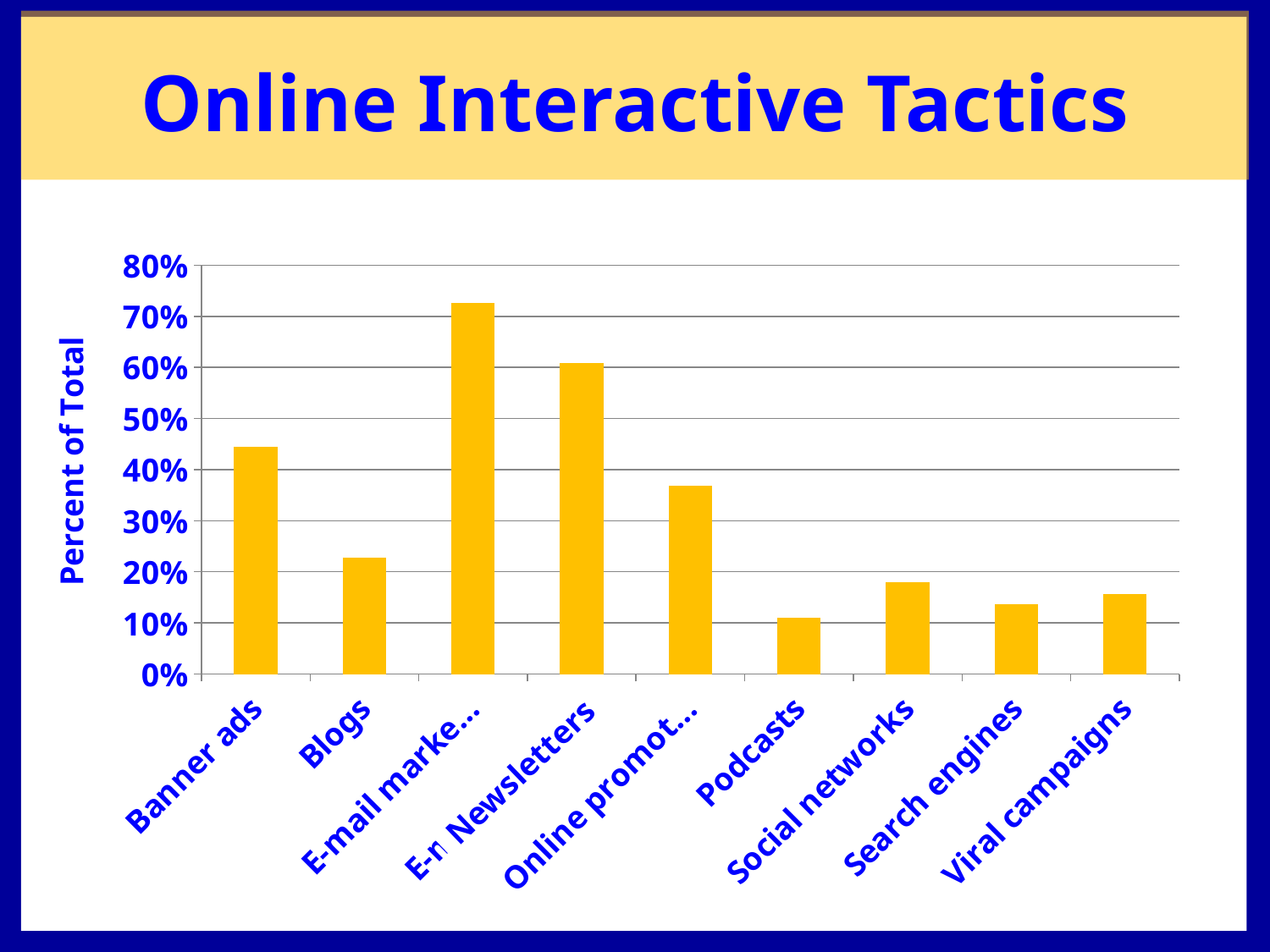
What kind of chart is shown on the slide? bar chart Which has a higher value, Banner ads or Blogs? Banner ads Which has a higher value, Podcasts or Social networks? Social networks Is the value for Podcasts greater or less than 20%? less How many categories (bars) are plotted in the chart? 9 What is the title of the slide containing the chart? Online Interactive Tactics Is the value for Banner ads greater or less than 40%? greater Is the value for Blogs greater or less than 30%? less Which has a higher value, Banner ads or Social networks? Banner ads What is the label on the vertical axis of the chart? Percent of Total